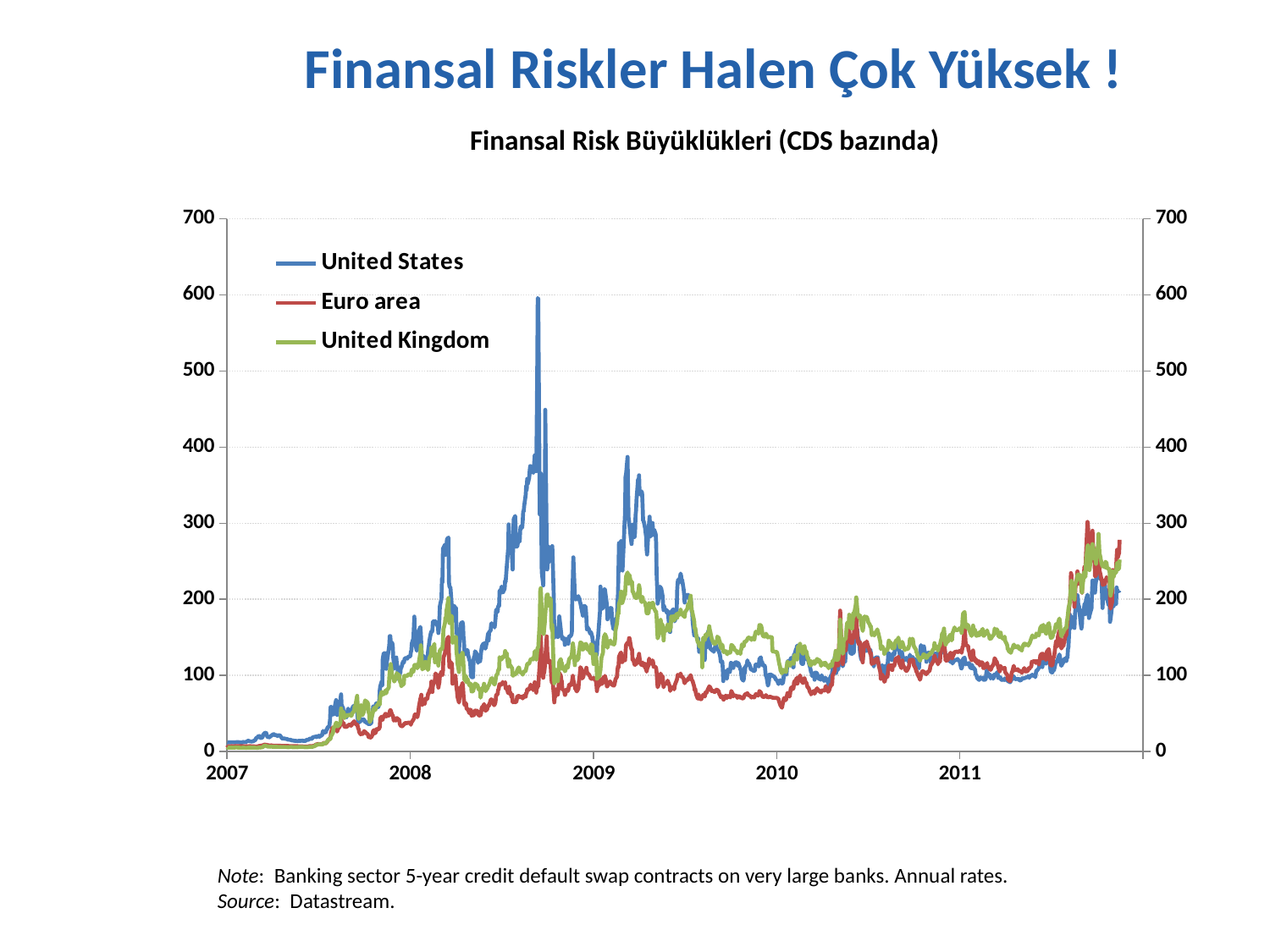
What is the maximum value shown on the vertical axis? 700 Which series has the lower value at the start of 2008, Euro area or United States? Euro area Do the values of the United States series rise or fall between the start of 2007 and the start of 2008? rise Which series reaches the highest peak over the whole period? United States What is the title of the chart? Finansal Risk Büyüklükleri (CDS bazında) Which series are listed in the legend? United States, Euro area, United Kingdom At the start of 2007, are the values of all three series greater or less than 100? less Is the highest peak of the United States series greater or less than 500? greater How many series does the legend list? 3 Is the highest value of the Euro area series greater or less than 400? less What kind of chart is shown on the slide? line chart